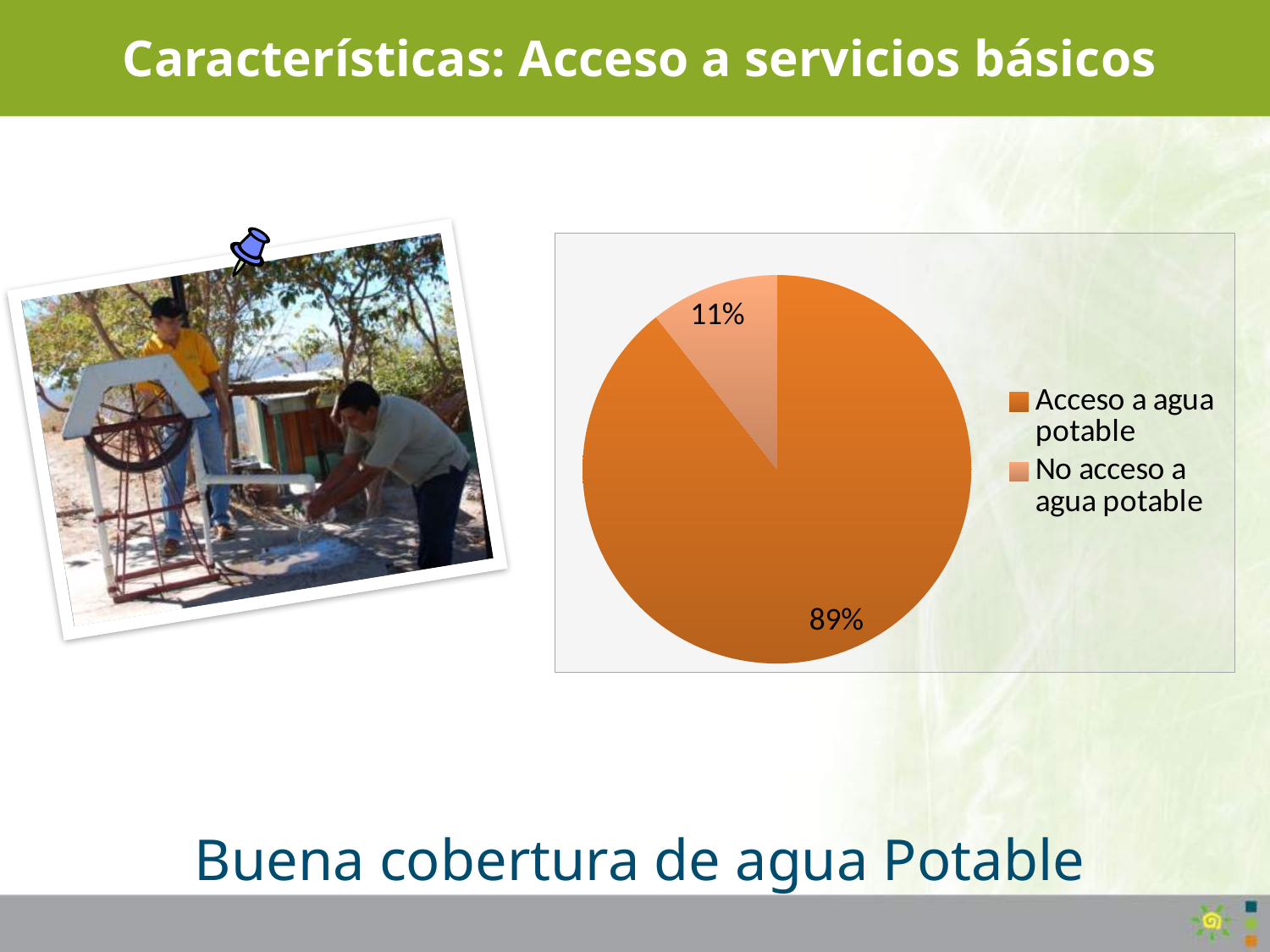
What percentage of the pie is labelled "Acceso a agua potable"? 89% How many entries does the legend list? 2 Which slice of the pie is the smallest? No acceso a agua potable What share of the pie does the "No acceso a agua potable" slice represent? 11% What kind of chart is shown on the slide? pie chart What percentage of the pie is labelled "No acceso a agua potable"? 11% What is the difference in percentage points between the "Acceso a agua potable" slice and the "No acceso a agua potable" slice? 78 Which slice of the pie is the largest? Acceso a agua potable How many slices does the pie chart have? 2 What colour is the "Acceso a agua potable" slice? orange Where is the legend positioned relative to the pie? to the right Which is larger: the "Acceso a agua potable" slice or the "No acceso a agua potable" slice? Acceso a agua potable